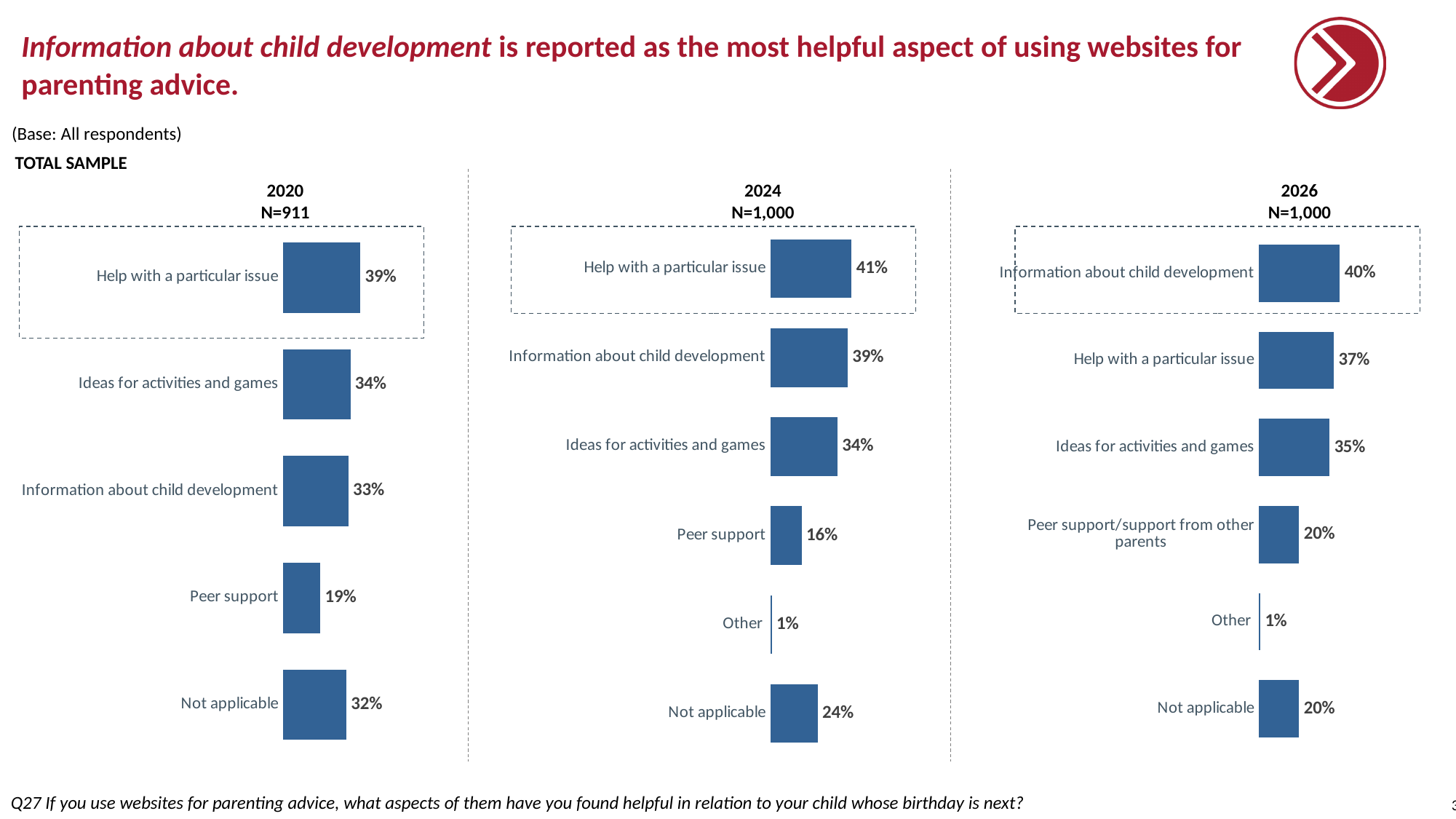
In the 2026 chart, what is the value for Peer support/support from other parents? 20% In the 2024 chart, which category has the lowest value? Other In the 2024 chart, which is larger: Not applicable or Peer support? Not applicable In the 2026 chart, which category has the highest value? Information about child development What type of chart is used for the 2024 data? Bar chart In the 2020 chart, what is the difference between Ideas for activities and games and Peer support? 15% How many categories are shown in the 2026 chart? 6 In the 2024 chart, what is the value for Information about child development? 39% In the 2026 chart, what is the difference between Information about child development and Help with a particular issue? 3% How many categories are shown in the 2020 chart? 5 In the 2020 chart, which category has the lowest value? Peer support In the 2020 chart, what is the value for Help with a particular issue? 39%